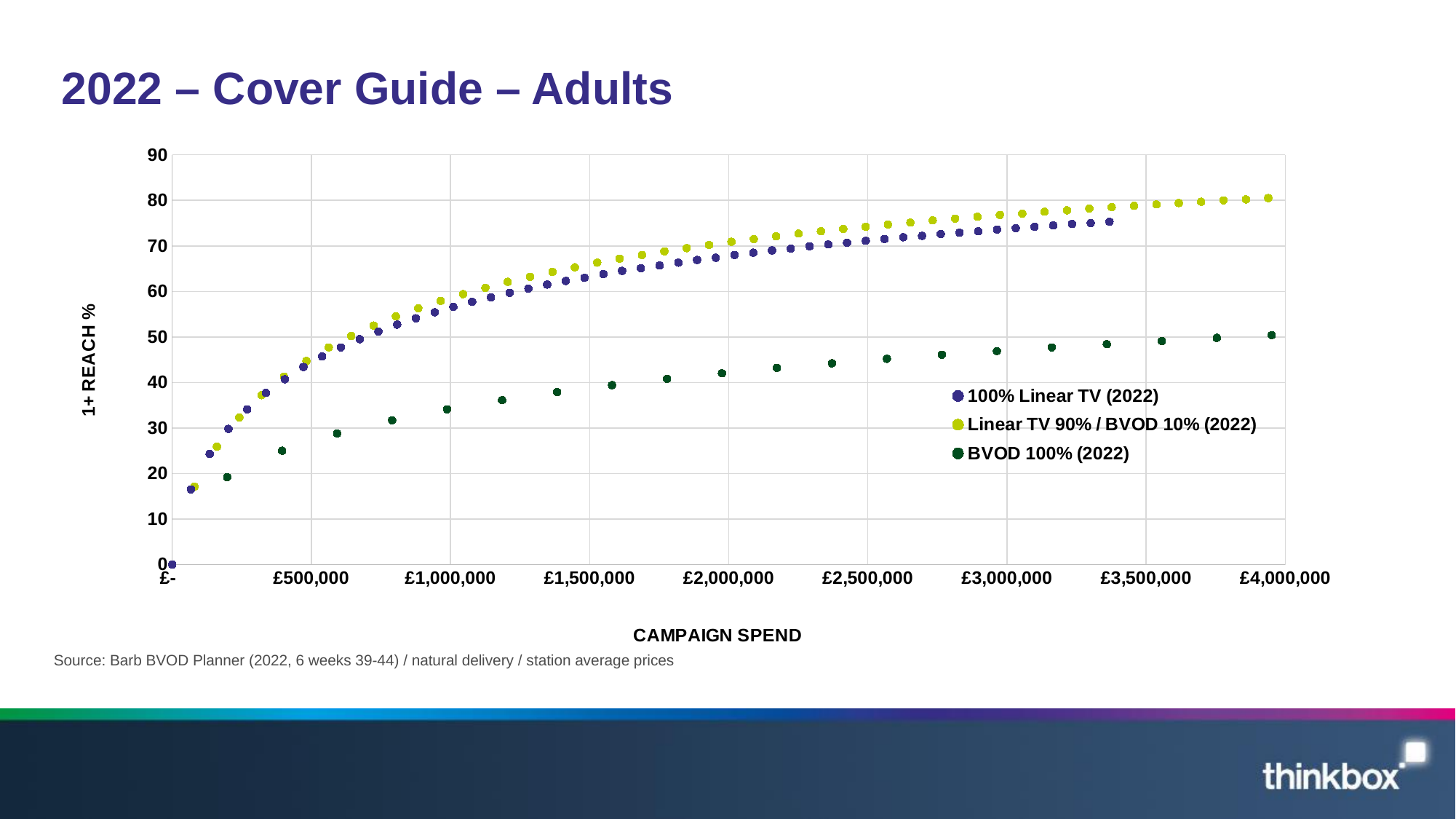
Is the 1+ reach for BVOD 100% (2022) at a campaign spend of £500,000 greater or less than 30? less Is the 1+ reach for BVOD 100% (2022) at a campaign spend of £3,000,000 greater or less than 50? less How many series does the legend list? 3 What is the label on the vertical axis? 1+ REACH % Which series has the highest 1+ reach at a campaign spend of £4,000,000? Linear TV 90% / BVOD 10% (2022) Does 1+ reach rise or fall as campaign spend increases for the 100% Linear TV (2022) series? rise Which series has the lowest 1+ reach at a campaign spend of £2,000,000? BVOD 100% (2022) Is the 1+ reach for 100% Linear TV (2022) at a campaign spend of £1,000,000 greater or less than 50? greater What are the three series named in the legend? 100% Linear TV (2022), Linear TV 90% / BVOD 10% (2022), BVOD 100% (2022) At a campaign spend of £2,000,000, which series has the higher 1+ reach: 100% Linear TV (2022) or BVOD 100% (2022)? 100% Linear TV (2022) What kind of chart is shown on the slide? scatter chart